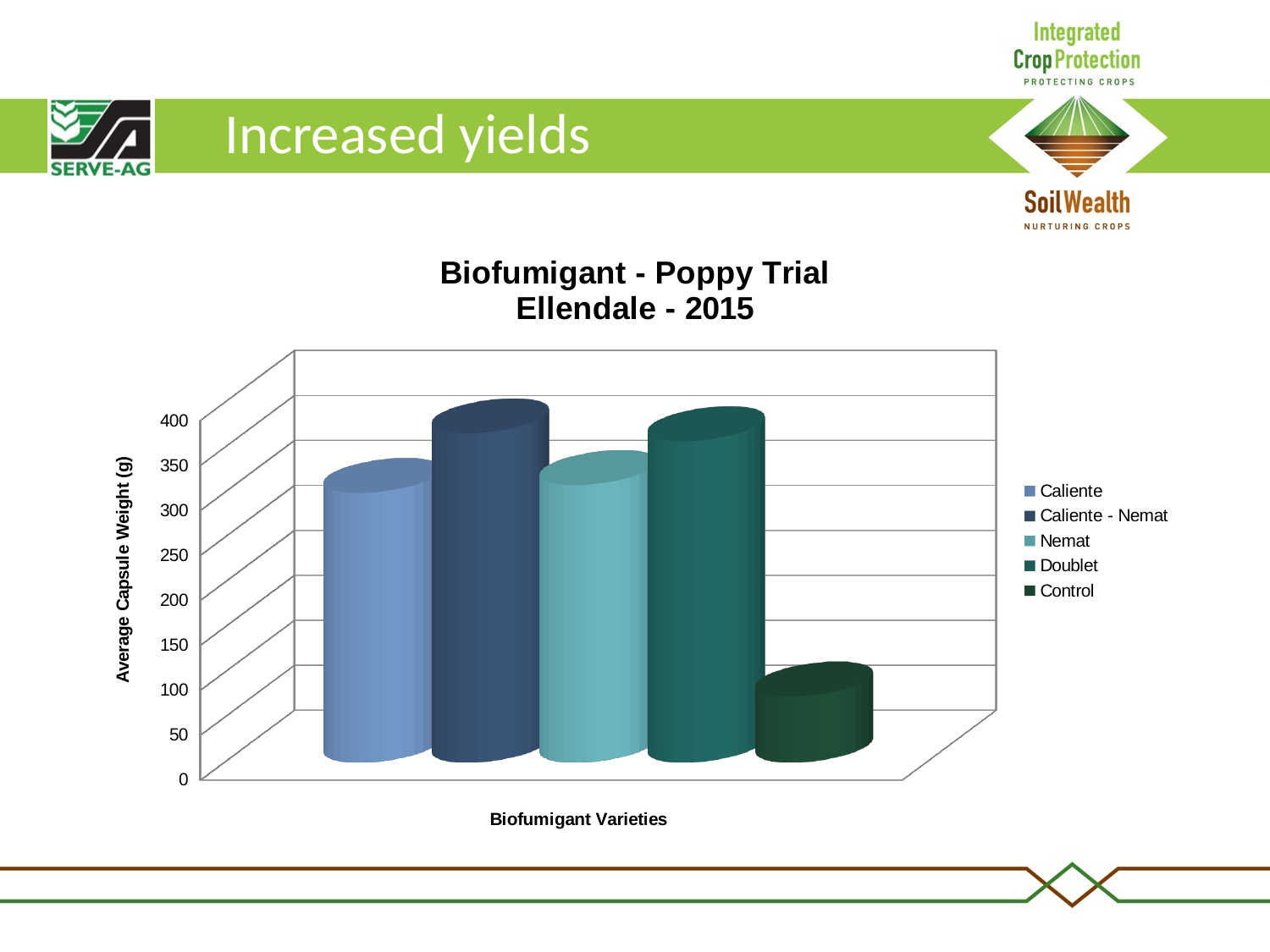
What is the label on the vertical axis? Average Capsule Weight (g) Which treatment has the lowest average capsule weight? Control Which is larger, the value for Doublet or the value for Nemat? Doublet Is the value for Caliente - Nemat greater or less than 350? greater How many series does the legend list? 5 Is the value for Control greater or less than 200? less How many bars are plotted in the chart? 5 Is the value for Nemat greater or less than 250? greater What kind of chart is shown on the slide? bar chart Which biofumigant variety has the highest average capsule weight? Caliente - Nemat What is the title of the chart? Biofumigant - Poppy Trial Ellendale - 2015